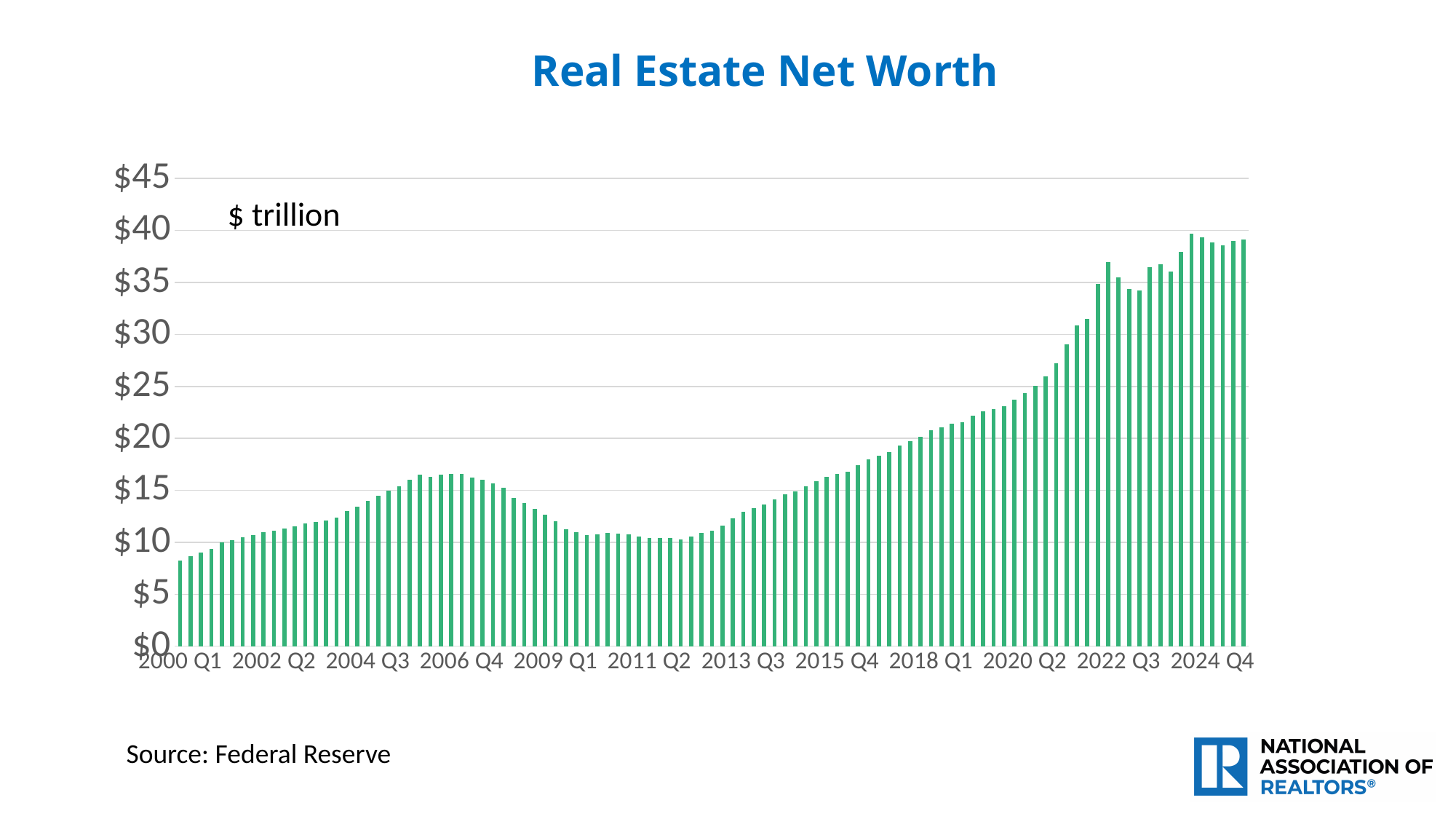
Is the value for 2000 Q1 greater or less than $10? less Overall, do real estate net worth values rise or fall from 2000 Q1 to 2024 Q4? rise Which is larger, the value for 2006 Q4 or the value for 2011 Q2? 2006 Q4 What kind of chart is shown on the slide? Bar chart Is the value for 2011 Q2 greater or less than $15? less Which labeled quarter on the x axis has the lowest real estate net worth? 2000 Q1 What is the title of the chart? Real Estate Net Worth Is the value for 2022 Q3 greater or less than $30? greater What unit is the chart's data expressed in? $ trillion